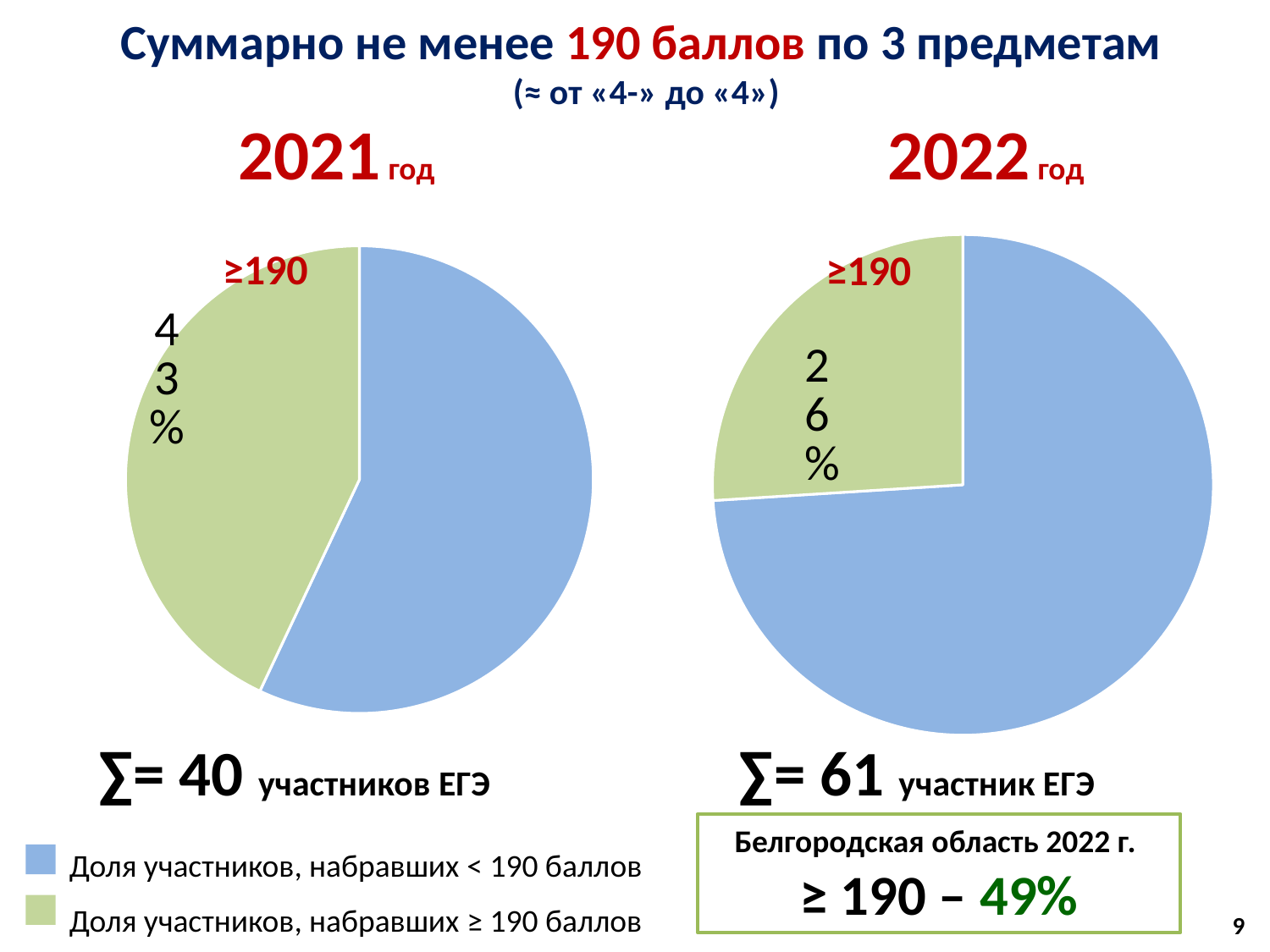
Which colour represents the share of participants who scored ≥ 190 points? Green By how many percentage points did the share of participants scoring ≥190 points fall from 2021 to 2022? 17 In the 2022 pie chart, which slice is the smallest? Participants scoring ≥ 190 points In the 2021 pie chart, what percentage of participants scored ≥190 points? 43% How many EGE participants are in the 2021 total shown below the left pie chart? 40 In the 2021 pie chart, which slice is larger: participants scoring < 190 points or participants scoring ≥ 190 points? Participants scoring < 190 points How many slices does the 2022 pie chart have? 2 Which year's pie chart shows a larger share of participants scoring ≥190 points, 2021 or 2022? 2021 In the 2022 pie chart, what percentage of participants scored ≥190 points? 26% How many EGE participants are in the 2022 total shown below the right pie chart? 61 How many categories does the legend list? 2 What type of chart is used for the 2021 and 2022 data on this slide? Pie chart